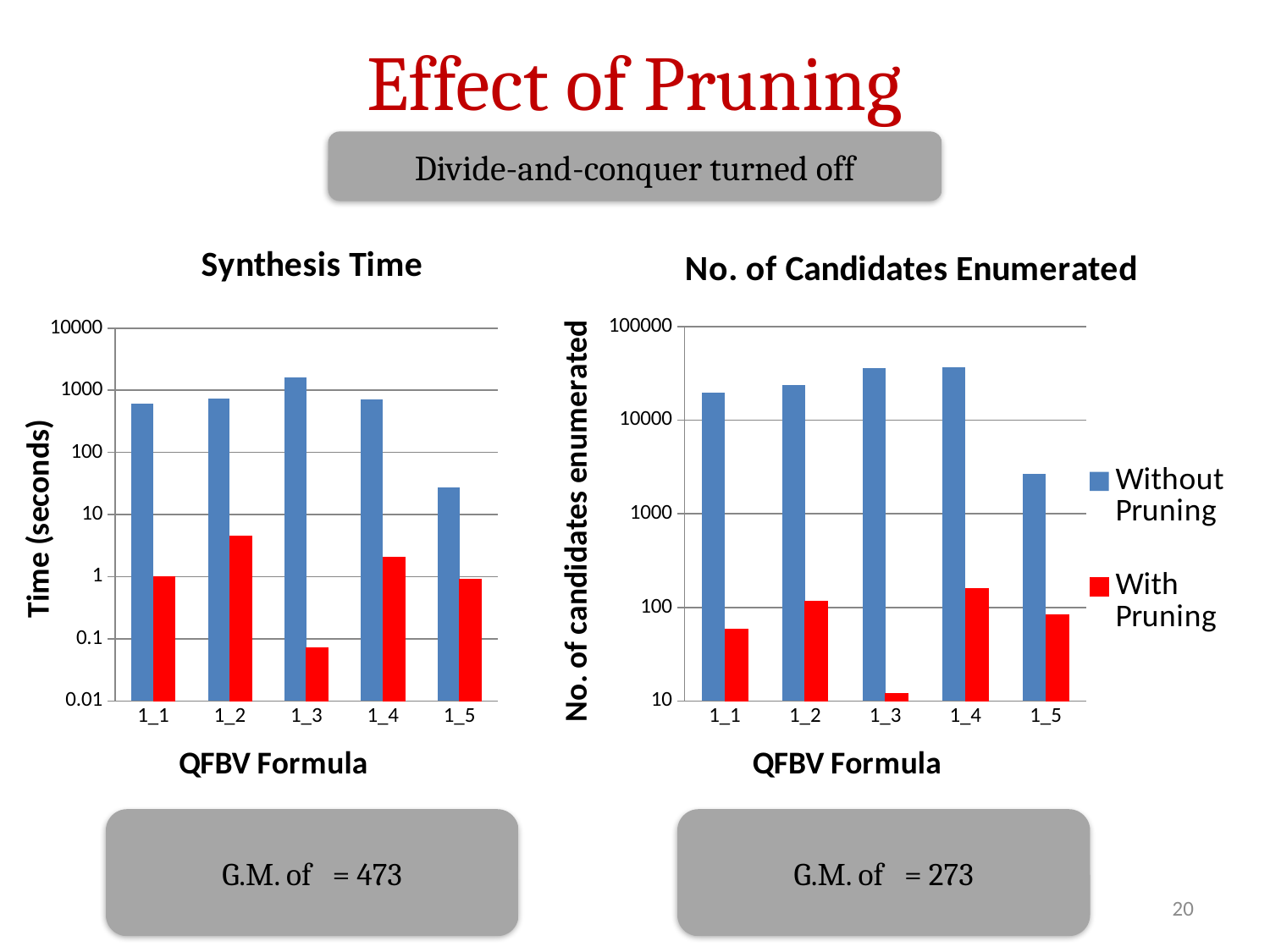
How many series does the legend list for the No. of Candidates Enumerated chart? 2 In the No. of Candidates Enumerated chart, is the Without Pruning value for 1_5 greater or less than 1000? greater In the No. of Candidates Enumerated chart, which QFBV formula has the lowest Without Pruning value? 1_5 In the Synthesis Time chart, which QFBV formula has the lowest Without Pruning time? 1_5 What is the y-axis label of the Synthesis Time chart? Time (seconds) In the Synthesis Time chart, which QFBV formula has the lowest With Pruning time? 1_3 In the Synthesis Time chart, is the With Pruning value for 1_3 greater or less than 0.1? less In the Synthesis Time chart, which QFBV formula has the highest Without Pruning time? 1_3 In the Synthesis Time chart, is the Without Pruning value for 1_3 greater or less than 1000? greater How many QFBV formulas are shown on the x axis of the No. of Candidates Enumerated chart? 5 What kind of chart is the Synthesis Time chart? bar chart